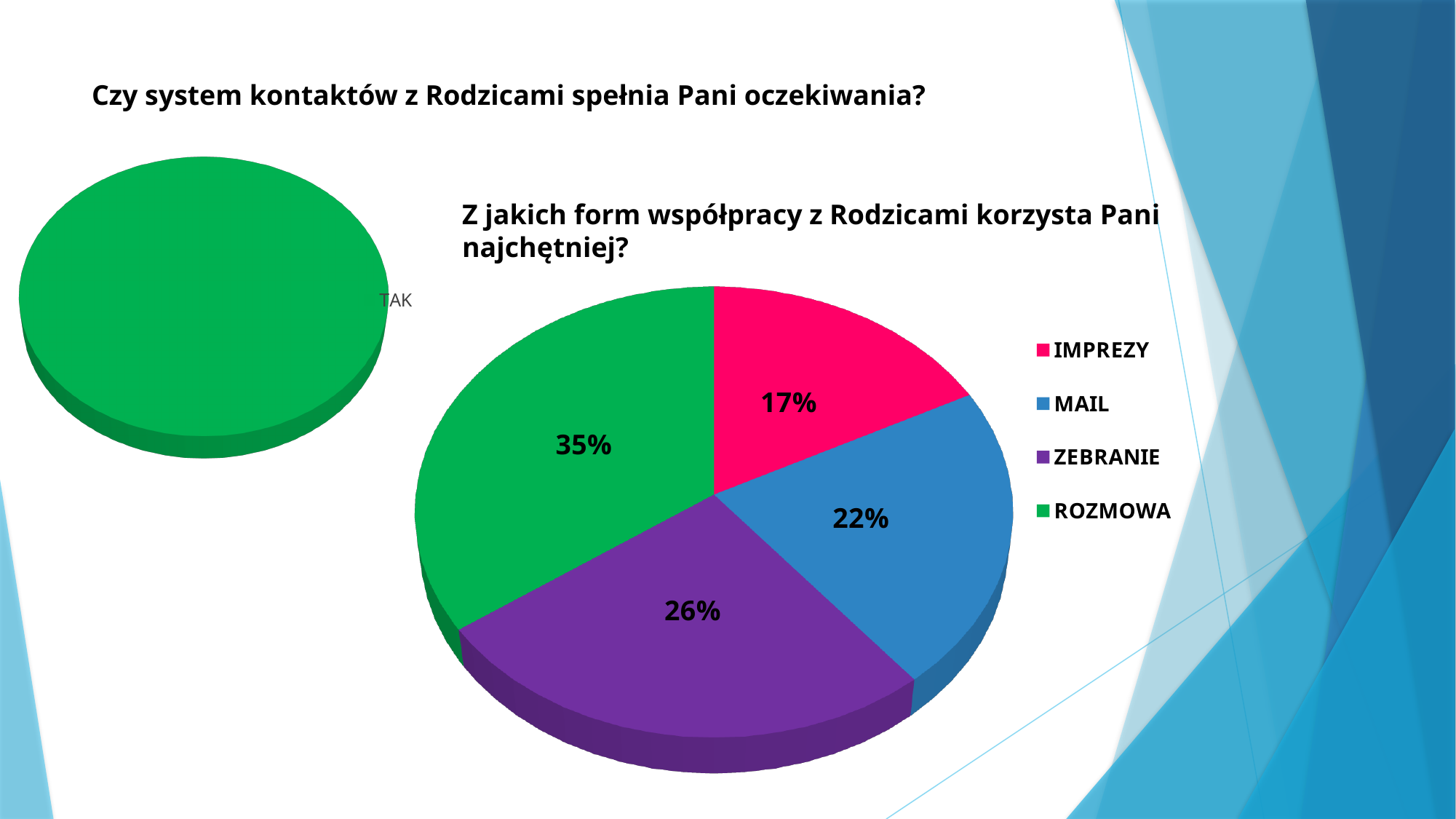
In the chart titled "Z jakich form współpracy z Rodzicami korzysta Pani najchętniej?", what share does MAIL have? 22% In the chart titled "Z jakich form współpracy z Rodzicami korzysta Pani najchętniej?", which is larger, ZEBRANIE or MAIL? ZEBRANIE In the chart titled "Z jakich form współpracy z Rodzicami korzysta Pani najchętniej?", which category has the largest share? ROZMOWA In the chart titled "Z jakich form współpracy z Rodzicami korzysta Pani najchętniej?", which category has the smallest share? IMPREZY In the chart titled "Z jakich form współpracy z Rodzicami korzysta Pani najchętniej?", what colour is the ZEBRANIE slice? Purple What kind of chart is the chart titled "Z jakich form współpracy z Rodzicami korzysta Pani najchętniej?"? Pie chart In the chart titled "Z jakich form współpracy z Rodzicami korzysta Pani najchętniej?", how many categories does the legend list? 4 In the chart titled "Z jakich form współpracy z Rodzicami korzysta Pani najchętniej?", what share does IMPREZY have? 17% In the chart titled "Z jakich form współpracy z Rodzicami korzysta Pani najchętniej?", what share does ZEBRANIE have? 26% In the chart titled "Z jakich form współpracy z Rodzicami korzysta Pani najchętniej?", what share does ROZMOWA have? 35% In the chart titled "Czy system kontaktów z Rodzicami spełnia Pani oczekiwania?", what is the only category label shown? TAK In the chart titled "Z jakich form współpracy z Rodzicami korzysta Pani najchętniej?", what is the difference in percentage points between ROZMOWA and IMPREZY? 18 percentage points